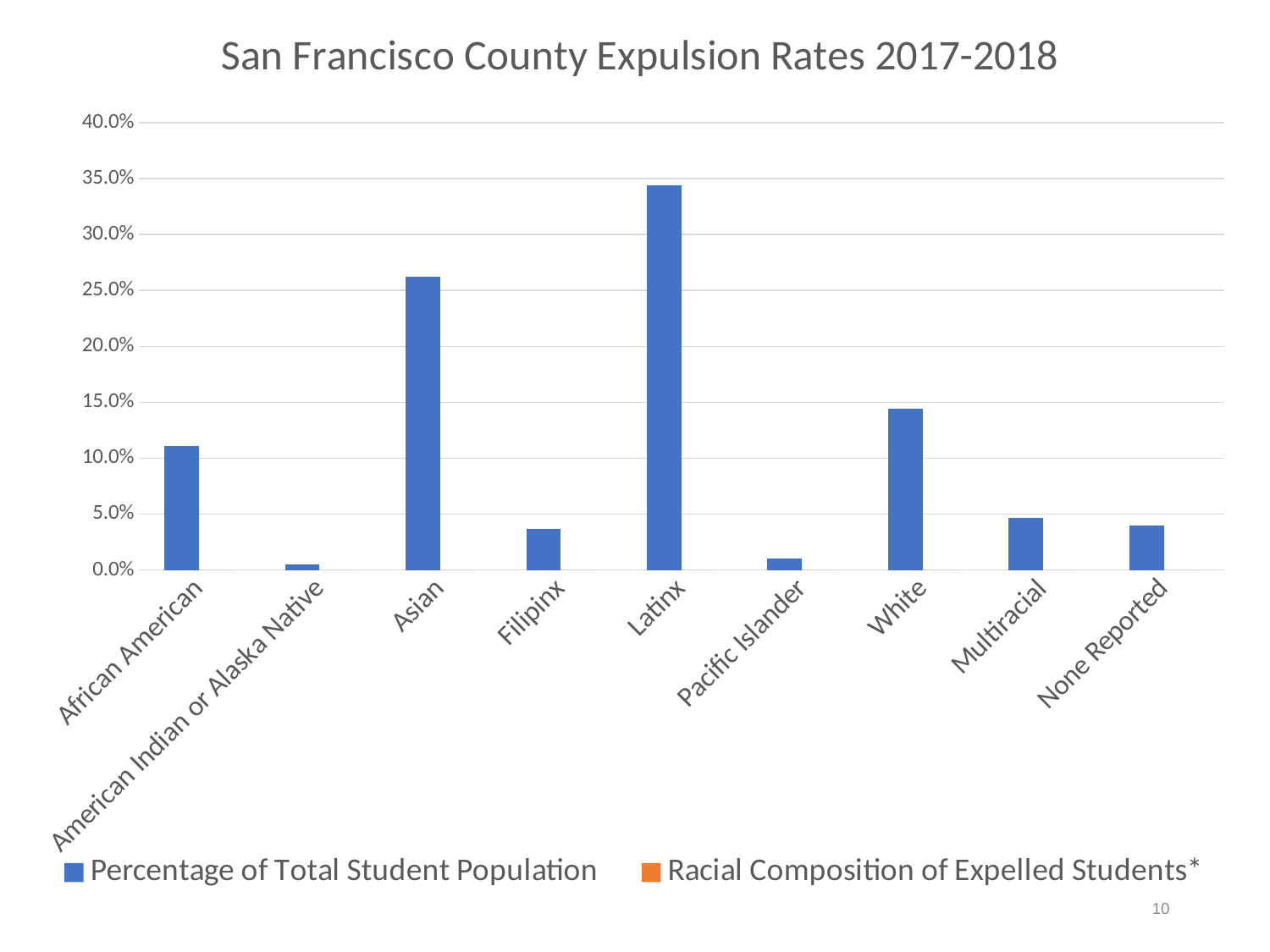
Which has a larger Percentage of Total Student Population, African American or White? White How many series does the legend list? 2 What is the title of the chart? San Francisco County Expulsion Rates 2017-2018 Is the Percentage of Total Student Population for Latinx greater or less than 30.0%? greater Which category has the lowest Percentage of Total Student Population? American Indian or Alaska Native Is the Percentage of Total Student Population for Asian greater or less than 20.0%? greater Is the Percentage of Total Student Population for White greater or less than 10.0%? greater Which has a larger Percentage of Total Student Population, Asian or White? Asian Which category has the highest Percentage of Total Student Population? Latinx How many categories are shown on the x axis of the chart? 9 What type of chart is shown on the slide? bar chart